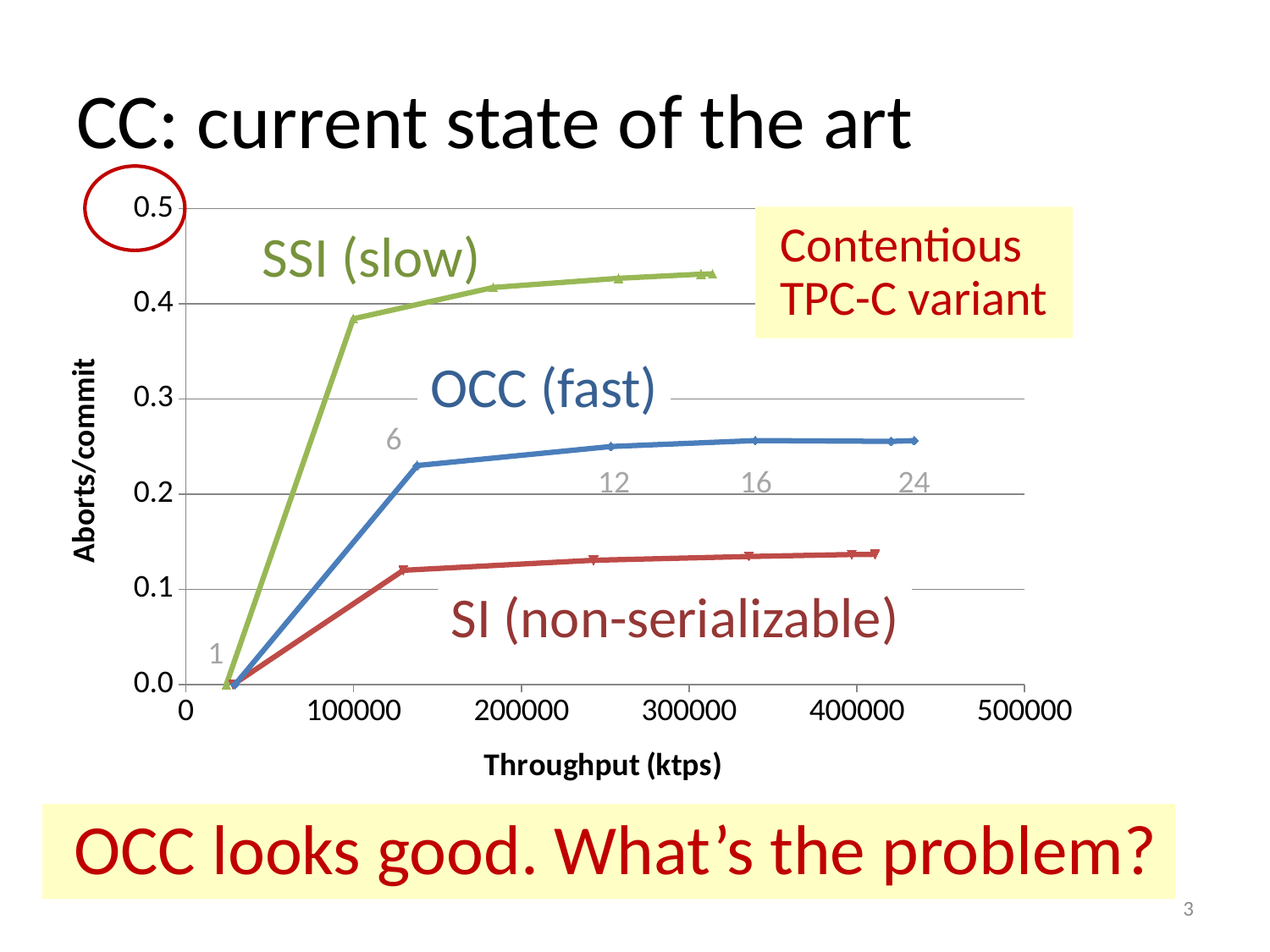
How many data series are plotted on the chart? 3 What is the title of the y axis? Aborts/commit Is the final value of the SI (non-serializable) series greater or less than 0.2? less Which series has the highest aborts/commit values? SSI (slow) Do the aborts/commit values rise or fall as throughput increases along the x axis? rise Which series extends to the highest throughput on the x axis? OCC (fast) What kind of chart is shown on the slide? line chart At a throughput of about 400000, which series has the larger aborts/commit value: OCC (fast) or SI (non-serializable)? OCC (fast) Is the final value of the SSI (slow) series greater or less than 0.4? greater What is the title of the x axis? Throughput (ktps) Which series has the lowest aborts/commit values? SI (non-serializable) Is the final value of the OCC (fast) series greater or less than 0.3? less